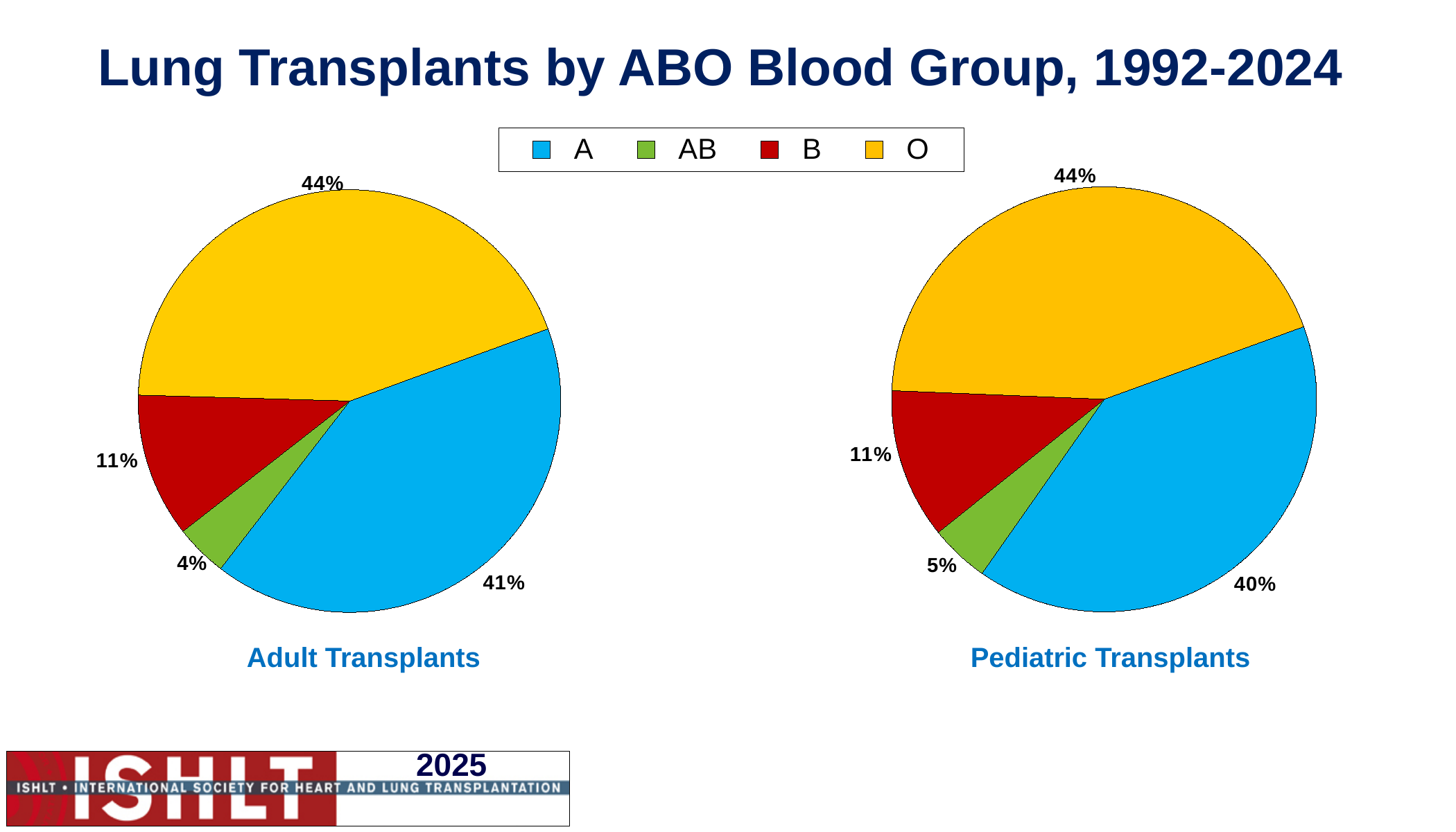
What colour represents blood group B in the legend? Red In the Adult Transplants pie chart, what share is blood group AB? 4% What kind of charts are shown on the slide? Pie charts In the Pediatric Transplants pie chart, what share is blood group B? 11% Is the share of blood group AB larger in the Adult Transplants pie chart or the Pediatric Transplants pie chart? Pediatric Transplants In the Pediatric Transplants pie chart, what is the difference between the shares of blood group B and blood group AB? 6% In the Pediatric Transplants pie chart, which blood group has the smallest share? AB In the Adult Transplants pie chart, which blood group has the largest share? O In the Adult Transplants pie chart, what share of lung transplants is blood group O? 44% In the Adult Transplants pie chart, what is the difference between the shares of blood group O and blood group A? 3% How many blood groups does the legend list? 4 In the Pediatric Transplants pie chart, what share of lung transplants is blood group A? 40%